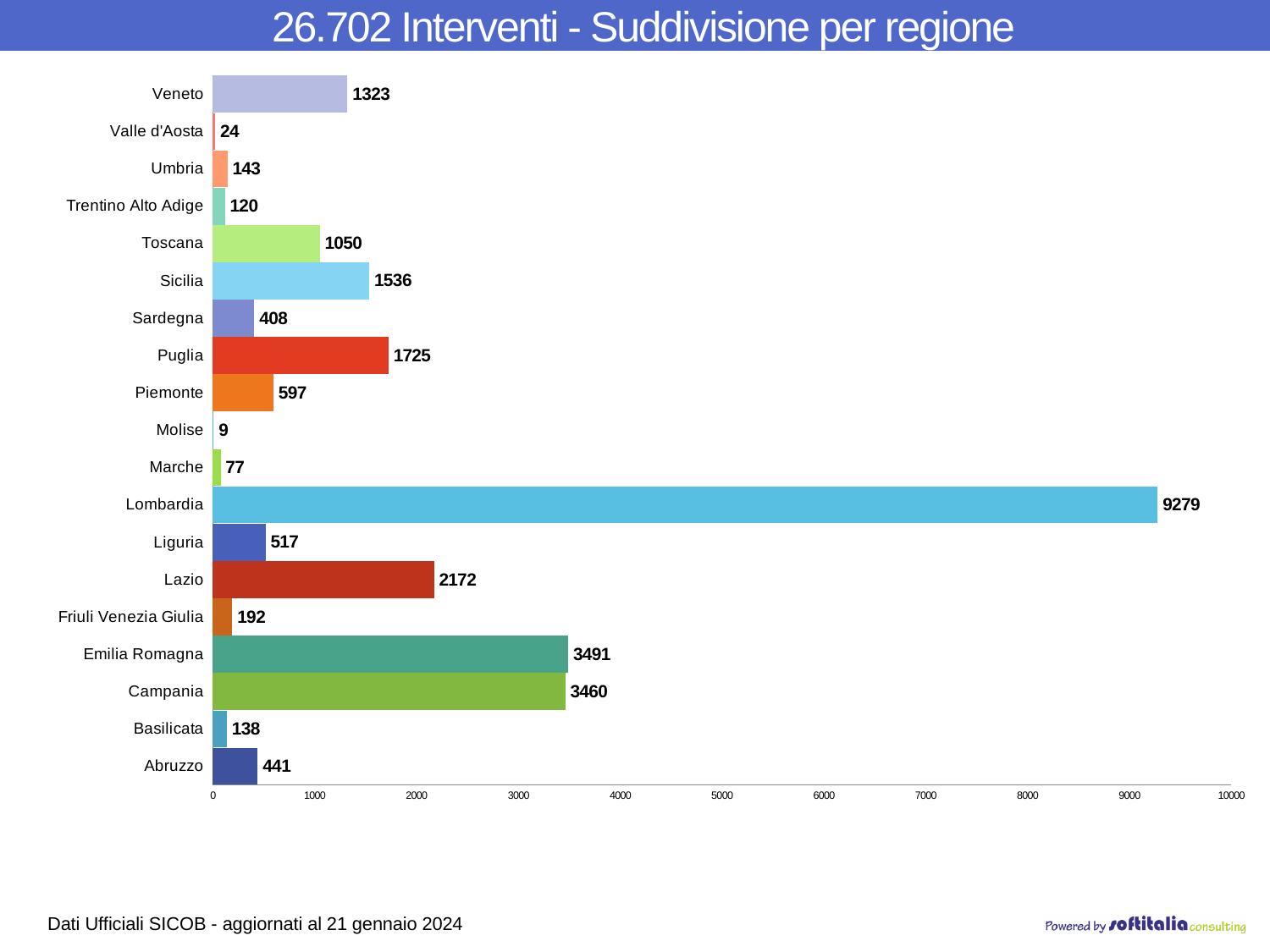
Which region has the highest value? Lombardia How many regions are shown in the chart? 19 What is the difference between the values for Puglia and Sicilia? 189 Which region has the lowest value? Molise What is the value for Valle d'Aosta? 24 What is the title of the chart? 26.702 Interventi - Suddivisione per regione Is the value for Lazio greater or less than 2000? greater What is the value for Lazio? 2172 What is the difference between the values for Emilia Romagna and Campania? 31 Which is larger, the value for Veneto or the value for Toscana? Veneto What is the value for Lombardia? 9279 What kind of chart is shown on the slide? bar chart